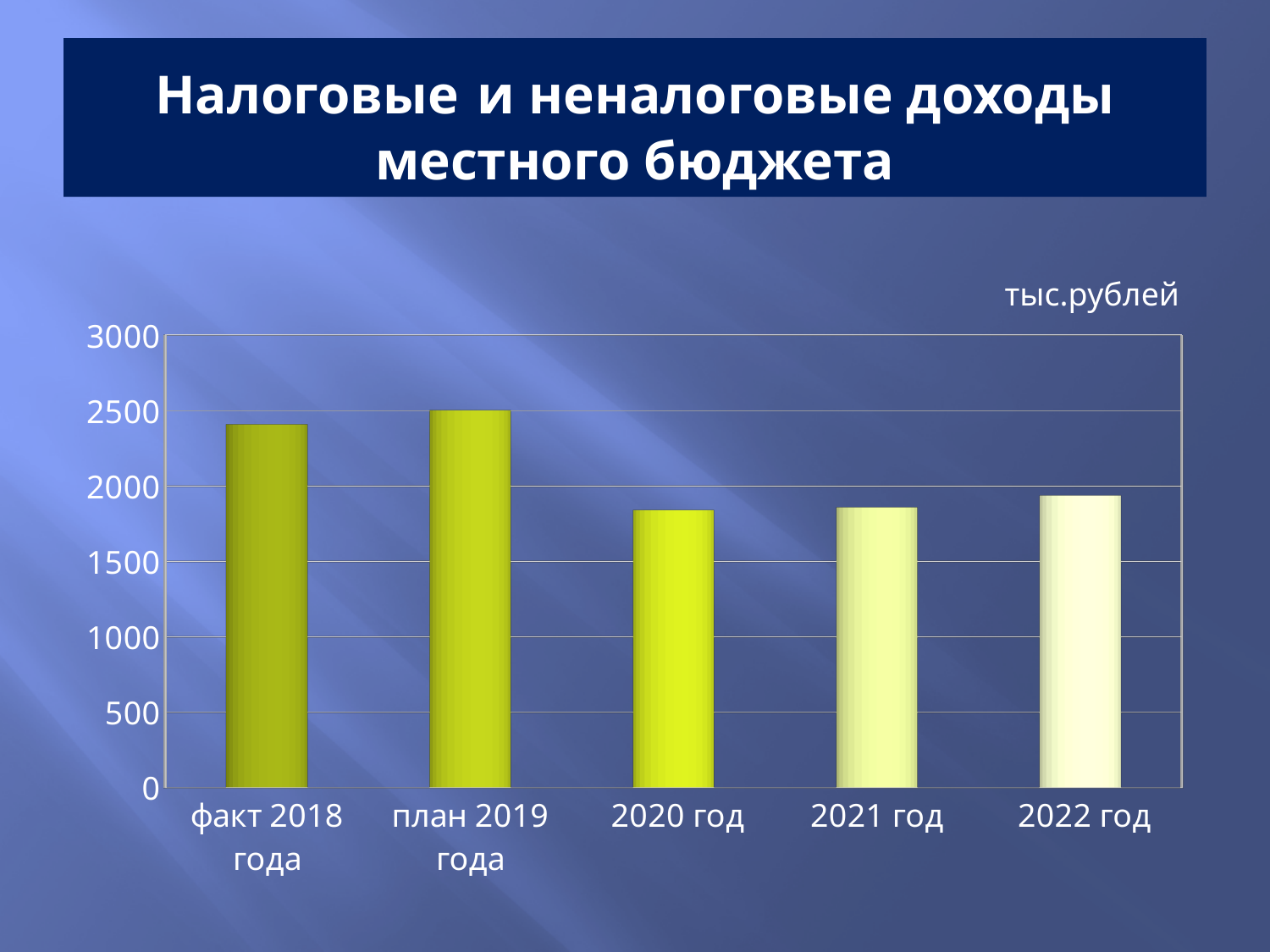
Is the value for 2022 год greater or less than 2500? less What kind of chart is shown on the slide? bar chart What is the title of the chart on the slide? Налоговые и неналоговые доходы местного бюджета How many categories are shown on the x axis of the chart? 5 Do the values rise or fall from план 2019 года to 2020 год? fall Is the value for факт 2018 года greater or less than 2000? greater Is the value for 2020 год greater or less than 2000? less Which is larger, the value for факт 2018 года or the value for 2020 год? факт 2018 года What unit is indicated above the chart? тыс.рублей Which category has the highest value in the chart? план 2019 года Which is larger, the value for 2022 год or the value for 2020 год? 2022 год